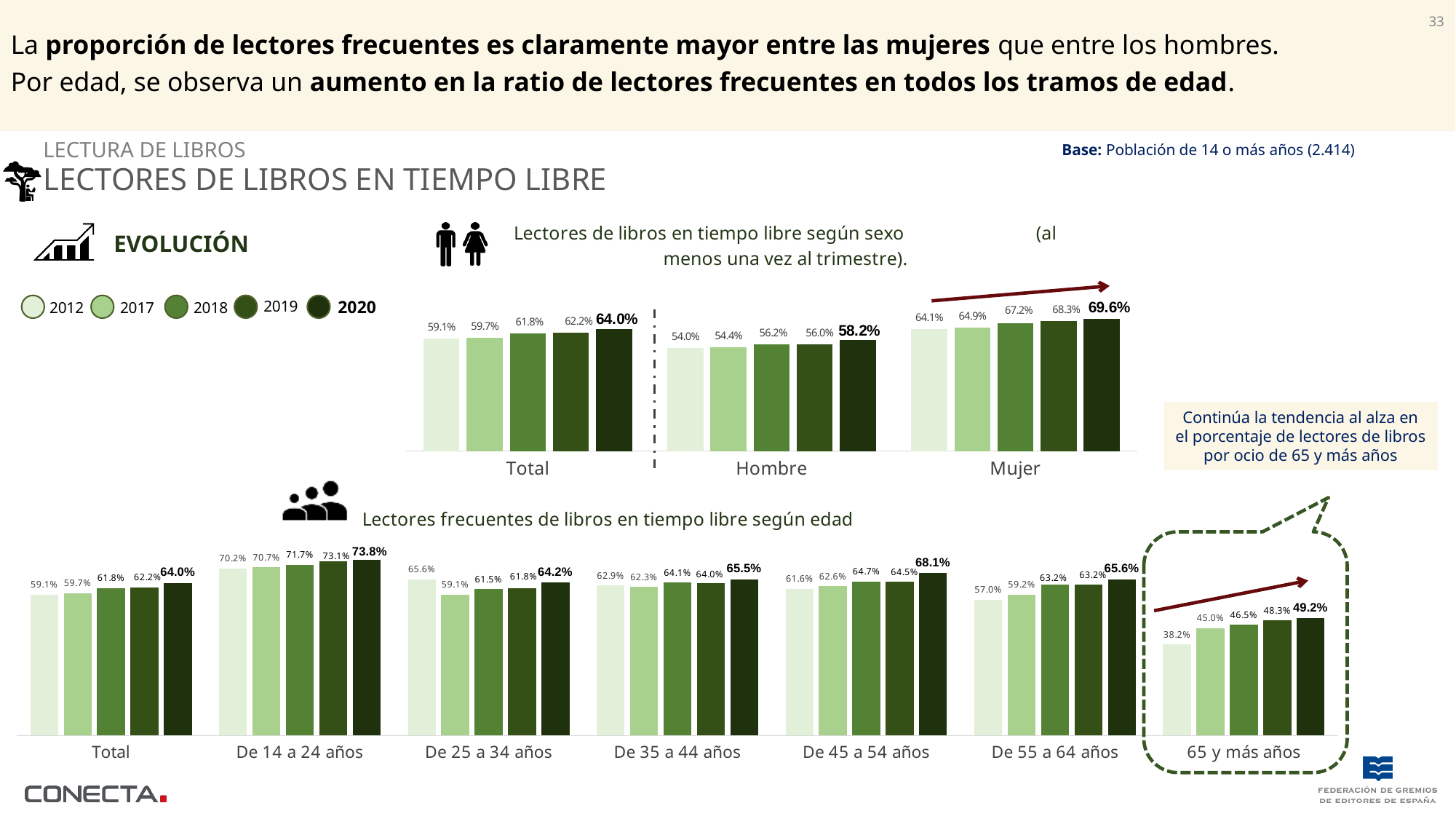
In the chart by sex (según sexo), what is the difference between the 2020 values for Mujer and Hombre? 11.4 percentage points In the chart by sex (según sexo), do the values for Total rise or fall from 2012 to 2020? rise In the chart by sex (según sexo), which group has the higher 2020 value, Hombre or Mujer? Mujer In the chart by age (según edad), how many age categories are shown, including Total? 7 In the chart by age (según edad), which age group has the highest 2020 value? De 14 a 24 años What type of chart is used for the data by age (según edad)? bar chart In the chart by sex (según sexo), what is the 2012 value for Hombre? 54.0% In the chart by age (según edad), which age group has the lowest 2020 value? 65 y más años How many series does the legend list for the charts on the slide? 5 In the chart by age (según edad), what is the 2020 value for De 45 a 54 años? 68.1% In the chart by sex (según sexo), what is the 2020 value for Mujer? 69.6% In the chart by age (según edad), what is the difference between the 2020 and 2012 values for 65 y más años? 11.0 percentage points